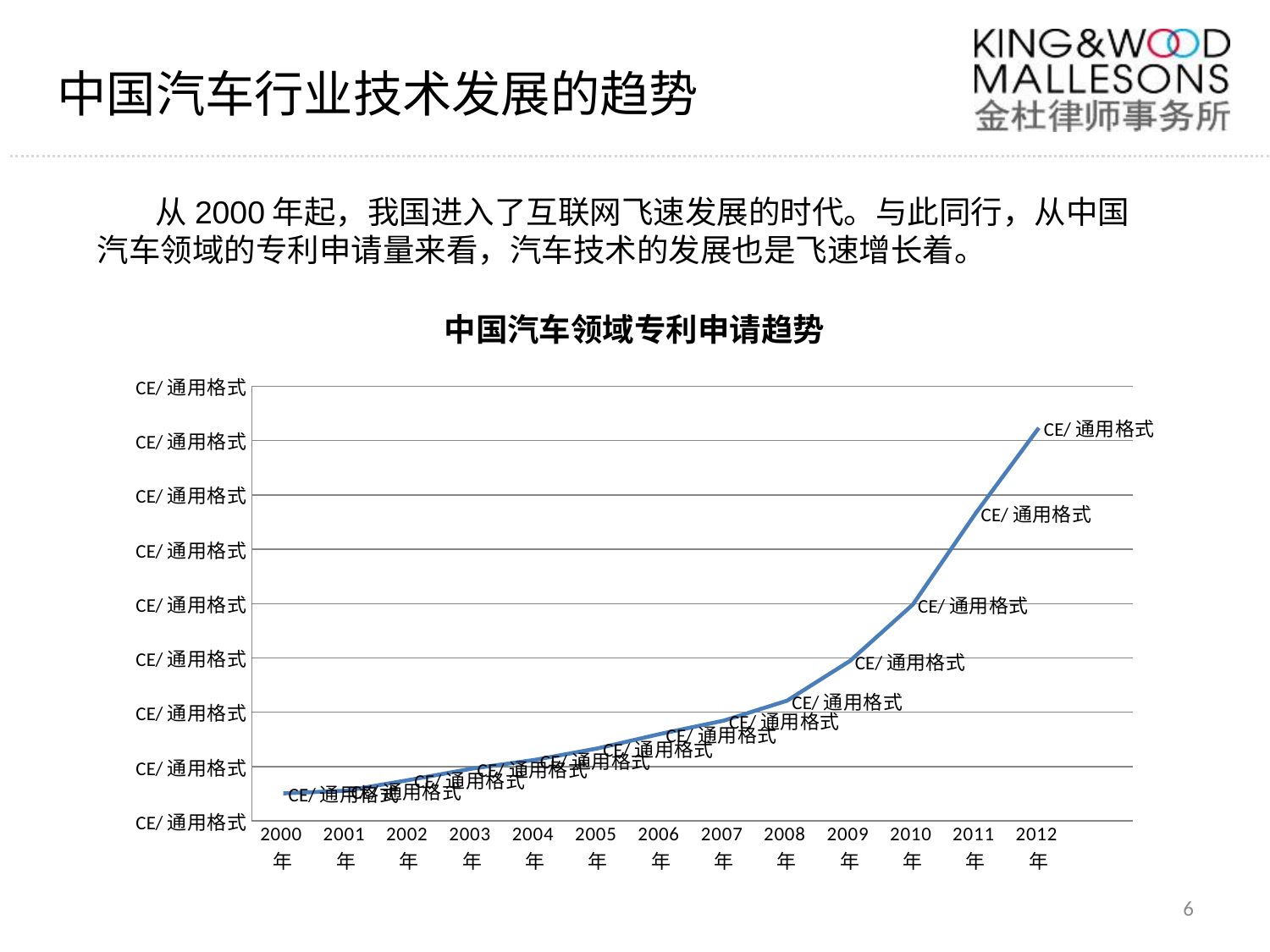
Which year has the highest value in the chart? 2012年 What is the title of the chart? 中国汽车领域专利申请趋势 Which has the larger value in the chart, 2010年 or 2005年? 2010年 Do the values in the chart rise or fall from 2000年 to 2012年? rise What is the first year shown on the x axis of the chart? 2000年 Which has the larger value in the chart, 2003年 or 2009年? 2009年 Which year has the lowest value in the chart? 2000年 Which has the larger value in the chart, 2008年 or 2011年? 2011年 In which part of the period does the line in the chart rise most steeply, the early years or the later years? the later years How many years are plotted along the x axis of the chart? 13 What kind of chart is shown on the slide? line chart